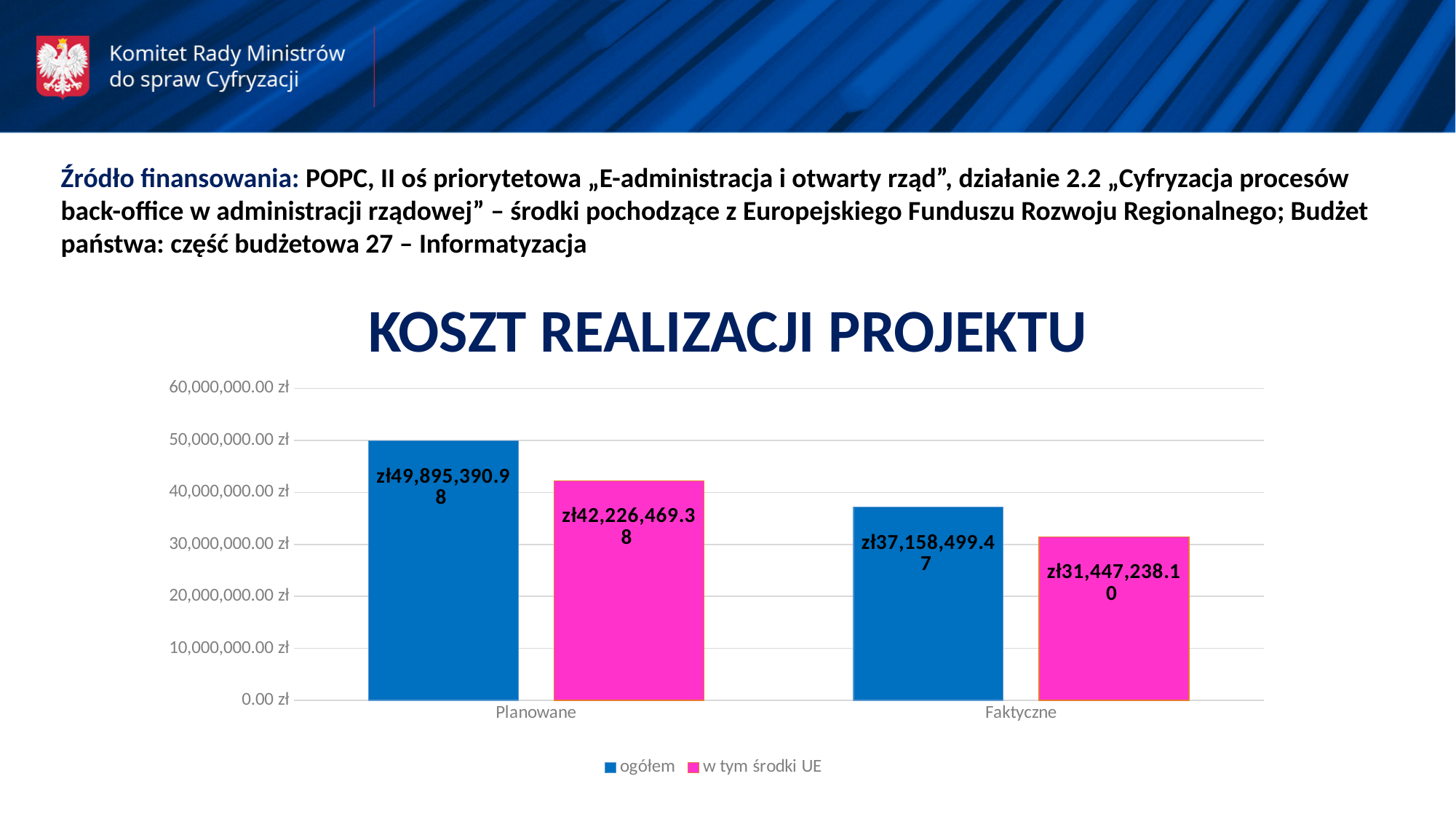
What is the value of w tym środki UE for Planowane? zł42,226,469.38 Which is larger: ogółem for Faktyczne or w tym środki UE for Planowane? w tym środki UE for Planowane What is the title of the chart? KOSZT REALIZACJI PROJEKTU What is the difference between ogółem and w tym środki UE for Planowane? zł7,668,921.60 How many series does the legend list? 2 What is the value of ogółem for Faktyczne? zł37,158,499.47 What is the value of ogółem for Planowane? zł49,895,390.98 Which bar has the highest value in the chart? ogółem for Planowane What is the value of w tym środki UE for Faktyczne? zł31,447,238.10 What kind of chart is shown on the slide? Bar chart What is the difference between the ogółem values for Planowane and Faktyczne? zł12,736,891.51 Which bar has the lowest value in the chart? w tym środki UE for Faktyczne